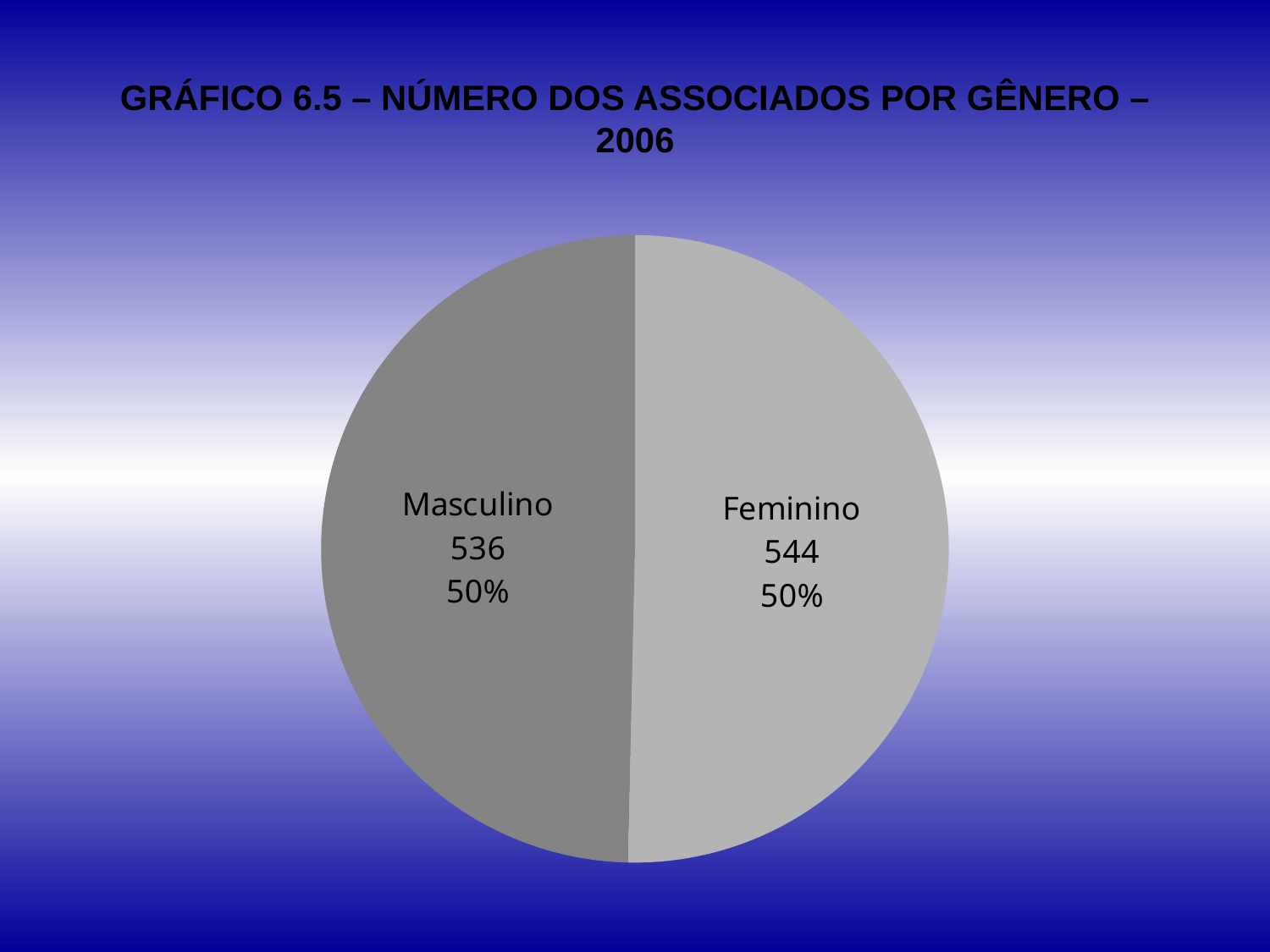
What is the total number of associates across both slices? 1080 What is the difference between the Feminino and Masculino values? 8 What percentage share is shown for the Masculino slice? 50% How many slices does the pie chart have? 2 Which category has the larger number of associates, Masculino or Feminino? Feminino Which category has the lowest value in the pie chart? Masculino What year is referenced in the chart title? 2006 Which category has the highest value in the pie chart? Feminino What is the number of associates for Feminino? 544 What percentage share is shown for the Feminino slice? 50% What type of chart is shown on the slide? pie chart What is the number of associates for Masculino? 536